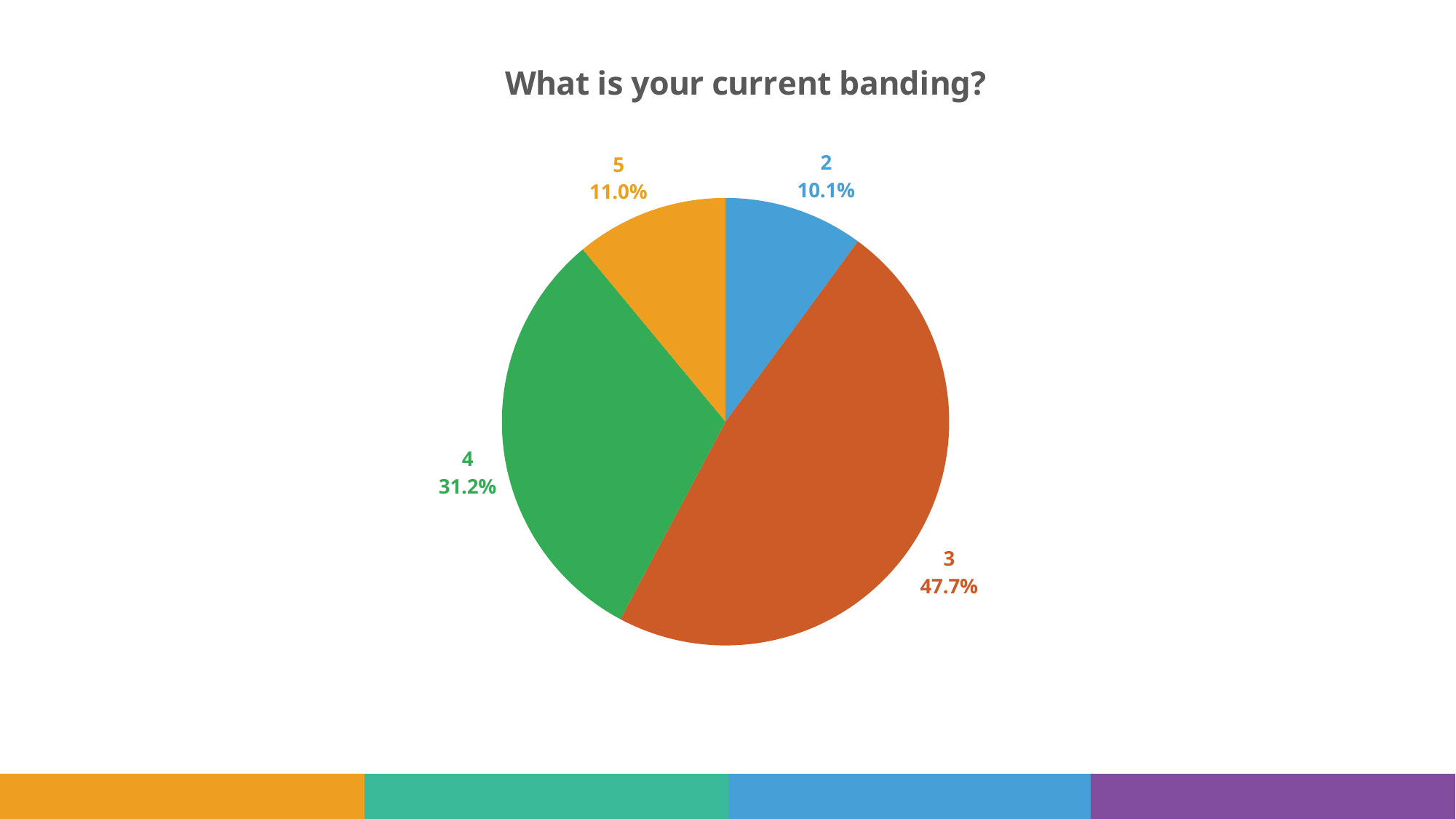
What share of the pie does banding 4 represent? 31.2% What share of the pie does banding 2 represent? 10.1% Which banding has the largest share of the pie? 3 What colour is the slice for banding 4? green Which has a larger share, banding 5 or banding 2? 5 What is the title of the chart? What is your current banding? What type of chart is shown on the slide? pie chart What share of the pie does banding 5 represent? 11.0% How many slices does the pie chart have? 4 What is the difference in percentage points between banding 3 and banding 4? 16.5 Which banding has the smallest share of the pie? 2